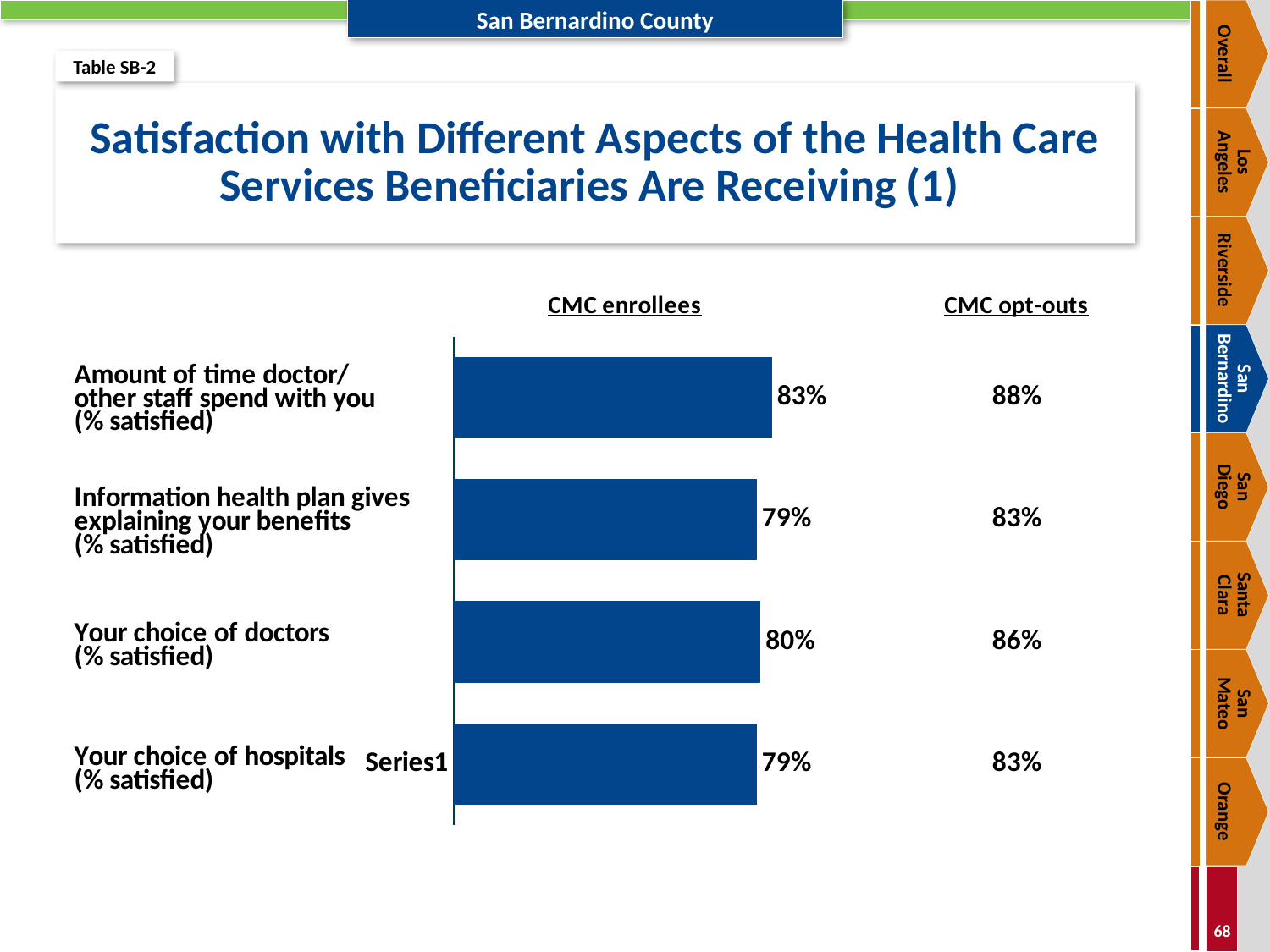
What percentage of CMC enrollees are satisfied with their choice of doctors? 80% What percentage of CMC opt-outs are satisfied with their choice of hospitals? 83% What type of chart is used to show the CMC enrollees values? Bar chart How many aspects of health care services are shown on the chart? 4 What is the difference between CMC opt-outs and CMC enrollees satisfaction with choice of doctors? 6 percentage points What is the title of the slide's chart? Satisfaction with Different Aspects of the Health Care Services Beneficiaries Are Receiving (1) Which aspect has the highest satisfaction among CMC enrollees? Amount of time doctor/other staff spend with you What percentage of CMC enrollees are satisfied with the amount of time doctor/other staff spend with them? 83% What percentage of CMC opt-outs are satisfied with the information the health plan gives explaining their benefits? 83% For choice of hospitals, which group has higher satisfaction, CMC enrollees or CMC opt-outs? CMC opt-outs Which aspect has the highest satisfaction among CMC opt-outs? Amount of time doctor/other staff spend with you What is the difference between CMC opt-outs and CMC enrollees satisfaction with the amount of time doctor/other staff spend with you? 5 percentage points